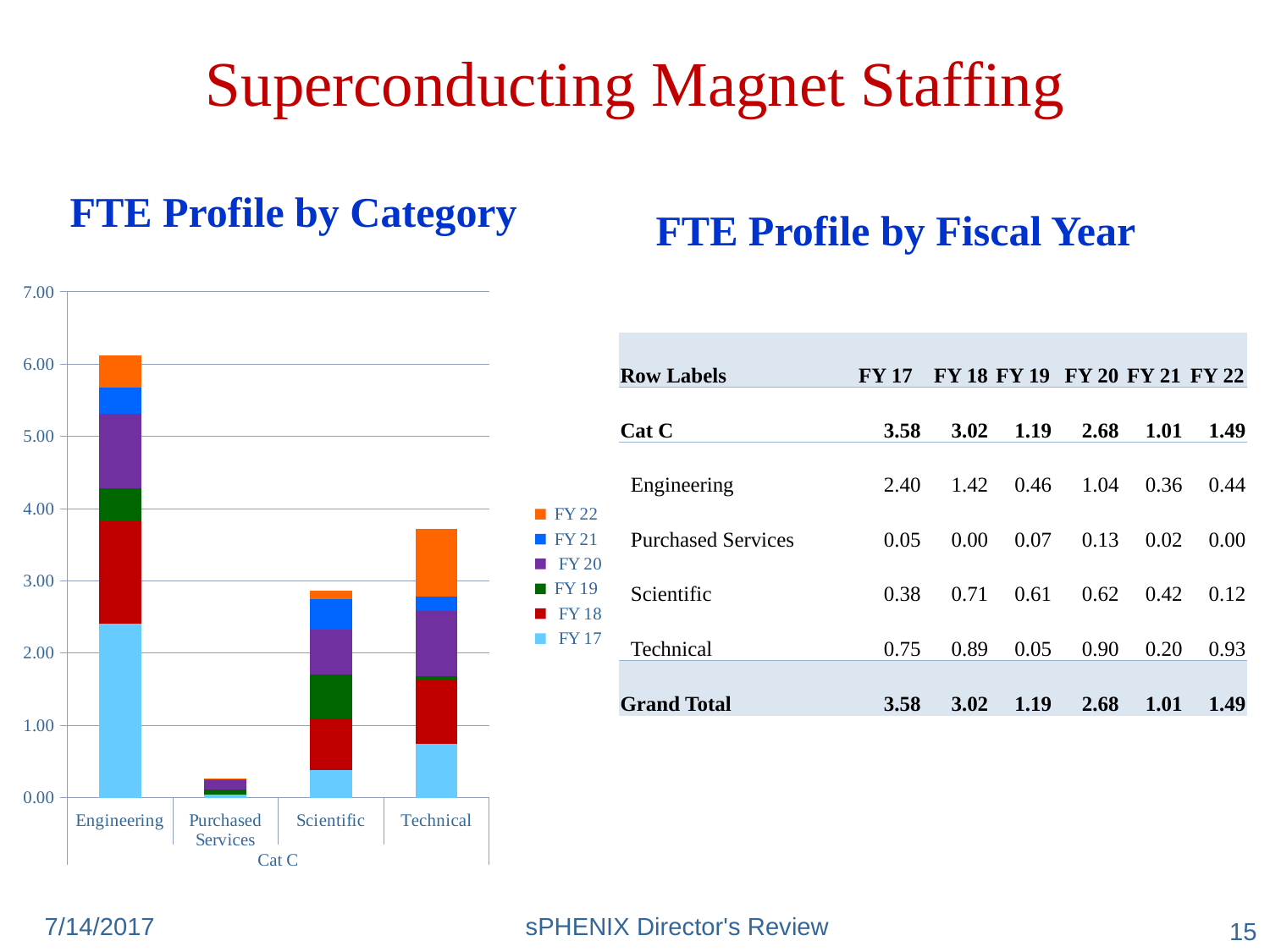
Which category has the tallest stacked bar in the chart? Engineering Which has the taller stacked bar, Technical or Scientific? Technical Is the total stacked bar for Technical greater or less than 3.00? greater How many categories are shown on the x axis of the chart? 4 What is the title of the chart on the left of the slide? FTE Profile by Category How many series does the chart's legend list? 6 Is the total stacked bar for Engineering greater or less than 5.00? greater What kind of chart is shown on the slide? stacked bar chart Which series is listed first (at the top) in the chart's legend? FY 22 Is the total stacked bar for Scientific greater or less than 4.00? less Which category has the shortest stacked bar in the chart? Purchased Services